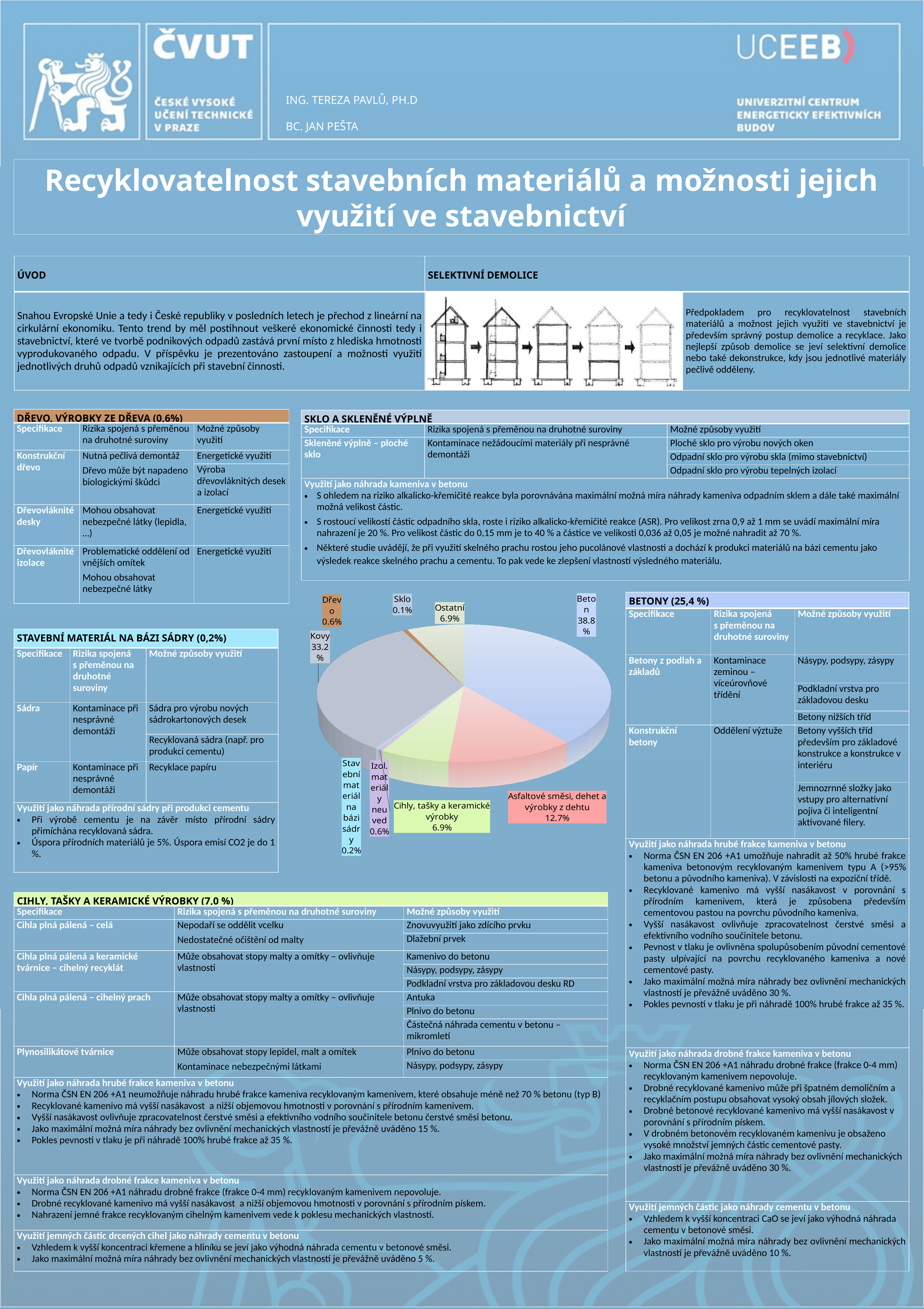
How many slices does the pie chart have? 9 In the pie chart, what share does Sklo have? 0.1% Which category has the smallest slice in the pie chart? Sklo In the pie chart, what share does Cihly, tašky a keramické výrobky have? 6.9% In the pie chart, what share does Beton have? 38.8% Which category has the largest slice in the pie chart? Beton In the pie chart, what share does Kovy have? 33.2% What kind of chart is shown in the centre of the slide? pie chart In the pie chart, what is the difference between the shares of Beton and Kovy? 5.6% In the pie chart, which is larger: Asfaltové směsi, dehet a výrobky z dehtu or Ostatní? Asfaltové směsi, dehet a výrobky z dehtu In the pie chart, what share does Asfaltové směsi, dehet a výrobky z dehtu have? 12.7% In the pie chart, what share does Stavební materiál na bázi sádry have? 0.2%